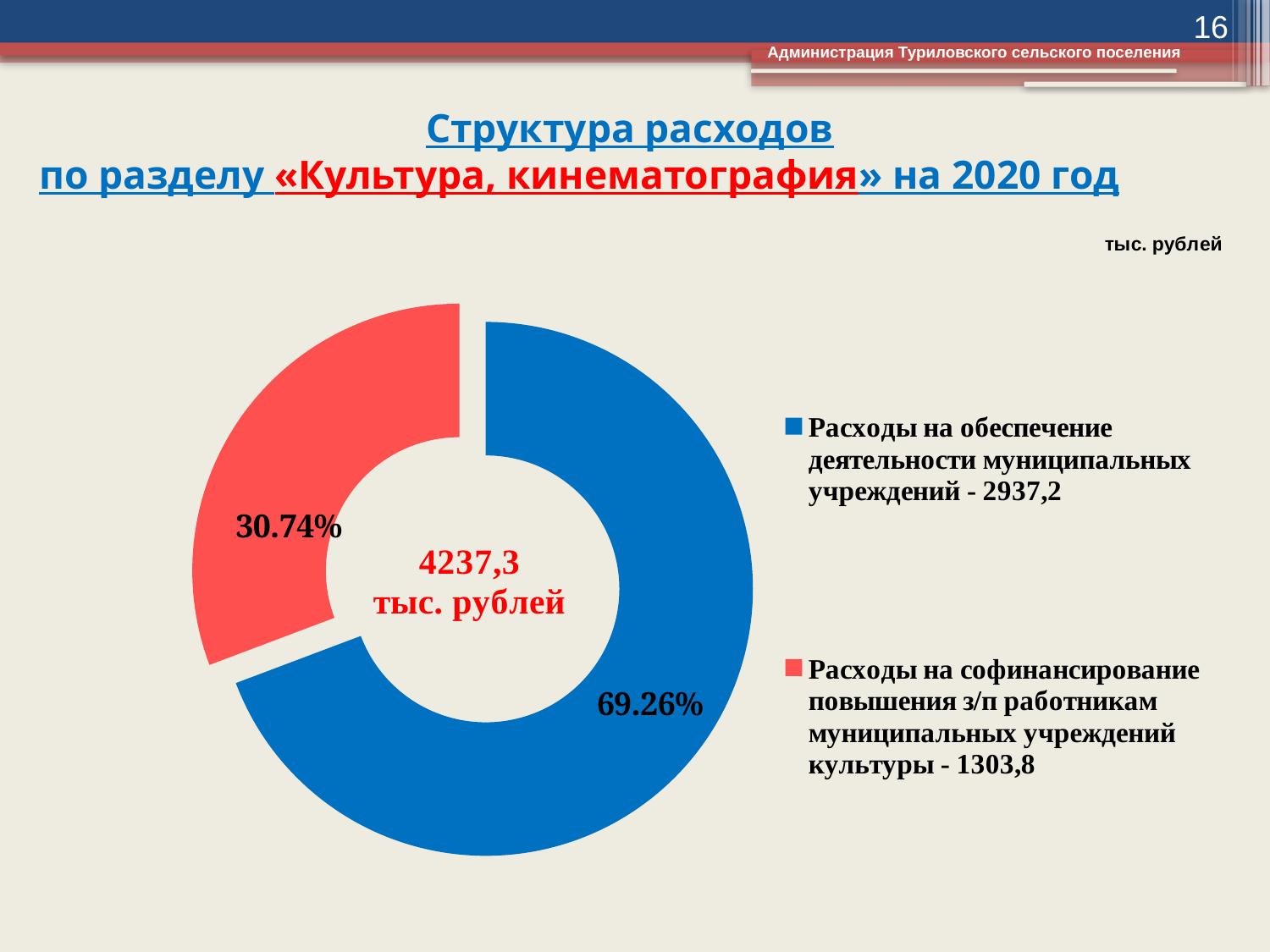
What colour is the slice for «Расходы на софинансирование повышения з/п работникам муниципальных учреждений культуры»? red What total amount is shown in the centre of the chart? 4237,3 тыс. рублей What share of the chart does the slice for «Расходы на обеспечение деятельности муниципальных учреждений» represent? 69.26% Which category has the smallest share of the chart? Расходы на софинансирование повышения з/п работникам муниципальных учреждений культуры What share of the chart does the slice for «Расходы на софинансирование повышения з/п работникам муниципальных учреждений культуры» represent? 30.74% What is the amount (тыс. рублей) for «Расходы на софинансирование повышения з/п работникам муниципальных учреждений культуры» according to the legend? 1303,8 How many categories (slices) does the chart have? 2 What kind of chart is shown on the slide? doughnut (pie) chart Which category has the largest share of the chart? Расходы на обеспечение деятельности муниципальных учреждений What is the difference in тыс. рублей between the two categories (2937,2 and 1303,8)? 1633,4 What is the amount (тыс. рублей) for «Расходы на обеспечение деятельности муниципальных учреждений» according to the legend? 2937,2 What is the difference in percentage points between the two slices (69.26% and 30.74%)? 38.52